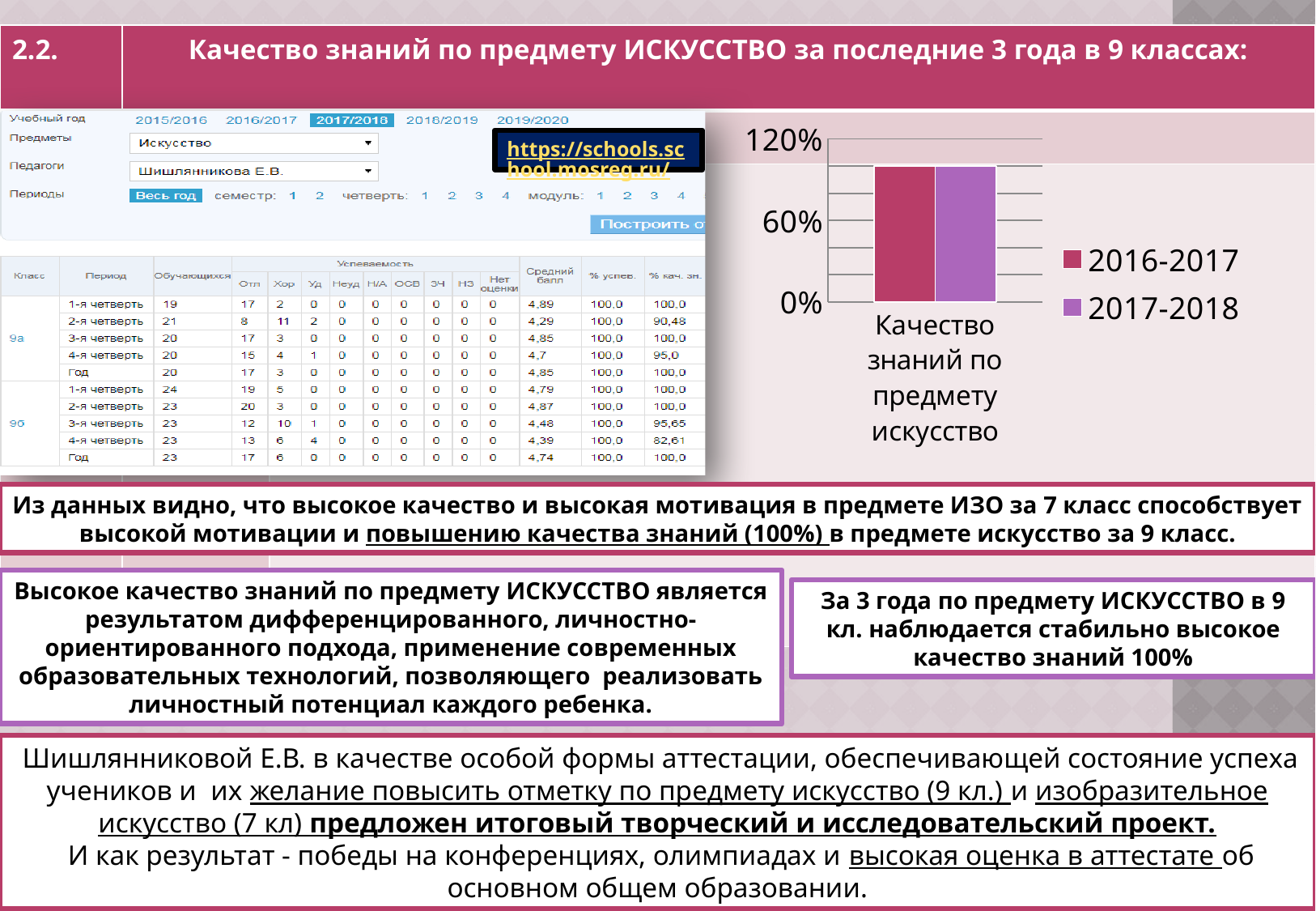
Is the value for 2016-2017 greater or less than 120%? less Is the value for 2016-2017 greater or less than 60%? greater What kind of chart is shown on the slide? bar chart What is the highest tick value shown on the chart's y axis? 120% Which series are listed in the chart legend? 2016-2017 and 2017-2018 Is the value for 2017-2018 greater or less than 120%? less How many categories are plotted on the x axis of the chart? 1 What is the category label on the x axis of the chart? Качество знаний по предмету искусство How many series does the chart legend list? 2